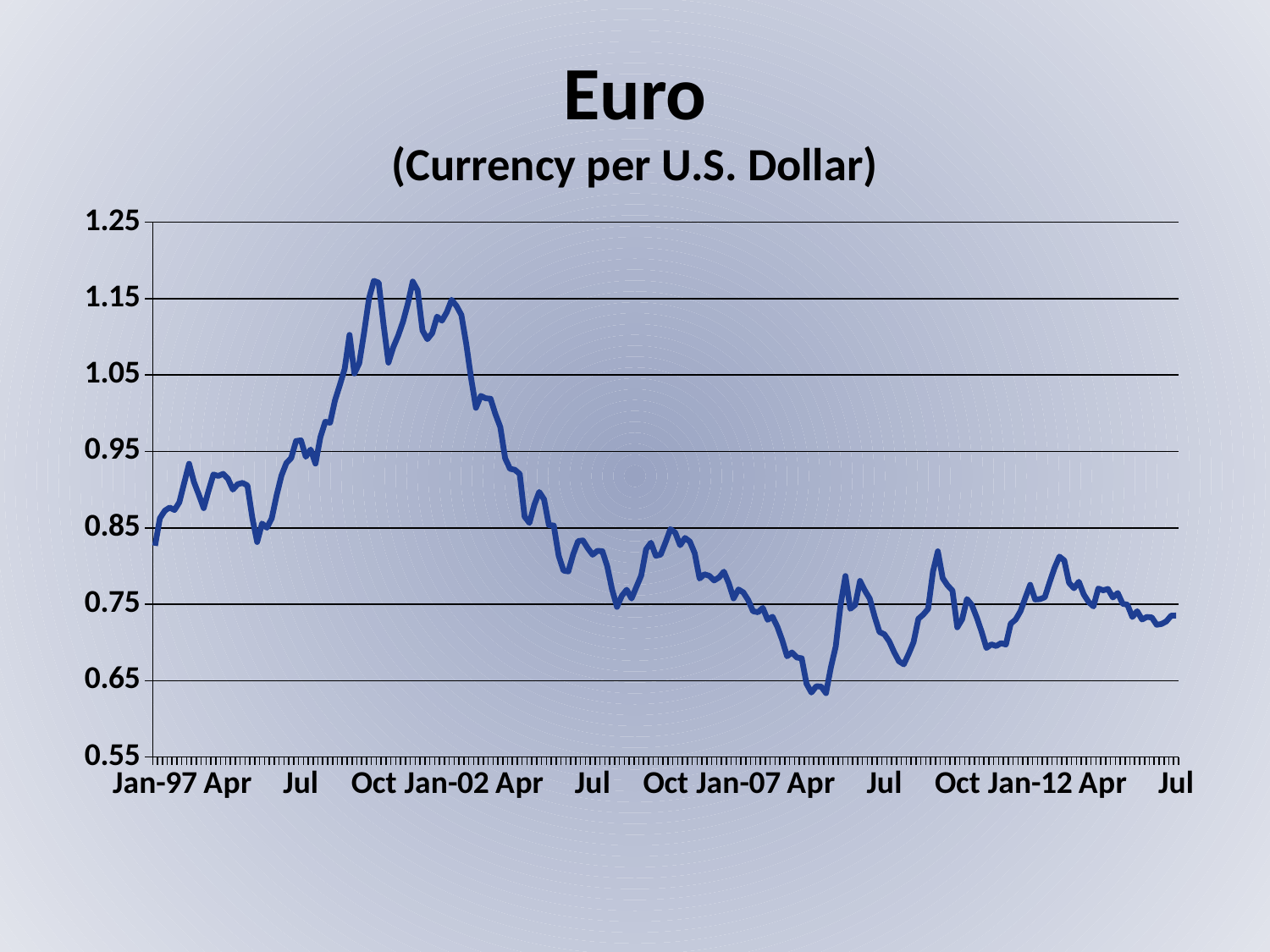
Is the peak value of the line greater or less than 1.15? greater What is the highest value shown on the vertical axis? 1.25 What is the title of the chart? Euro (Currency per U.S. Dollar) What kind of chart is shown on the slide? line chart Is the value at Jan-02 greater or less than 1.05? greater Is the value at Jan-12 greater or less than 0.85? less Does the line generally rise or fall between Jan-97 and Jan-02? rise Does the line generally rise or fall between Jan-02 and Jan-07? fall Which is larger, the value at Jan-02 or the value at Jan-12? Jan-02